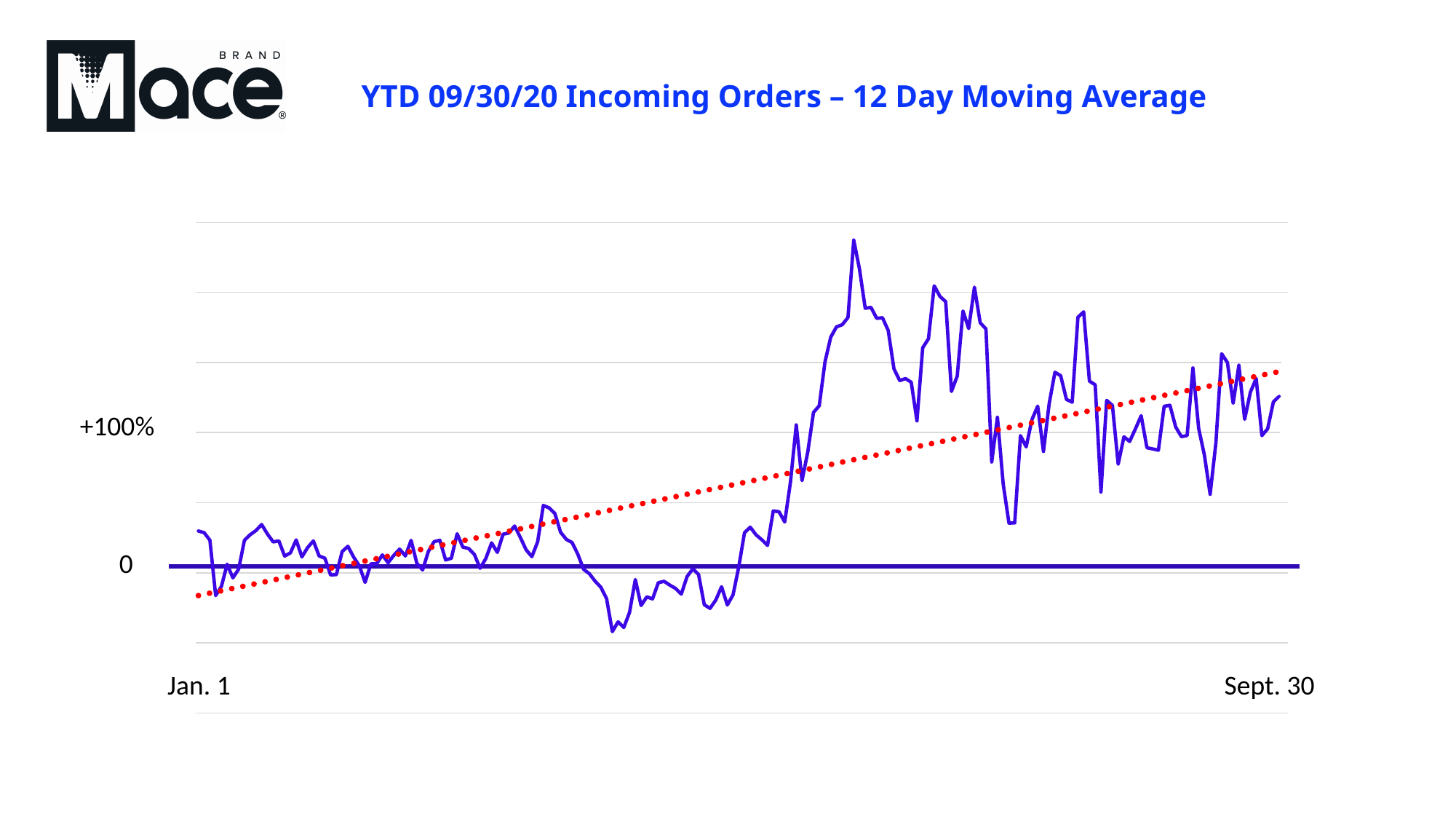
Is the value of the moving average at Jan. 1 greater or less than 0? greater What kind of chart is shown on the slide? line chart Is the value of the moving average at Sept. 30 greater or less than +100%? greater Does the dotted trend line rise or fall from Jan. 1 to Sept. 30? rise Is the highest peak of the moving average line greater or less than +100%? greater What is the title of the chart? YTD 09/30/20 Incoming Orders – 12 Day Moving Average Overall, does the 12 day moving average line rise or fall from Jan. 1 to Sept. 30? rise What colour is the dotted trend line on the chart? red